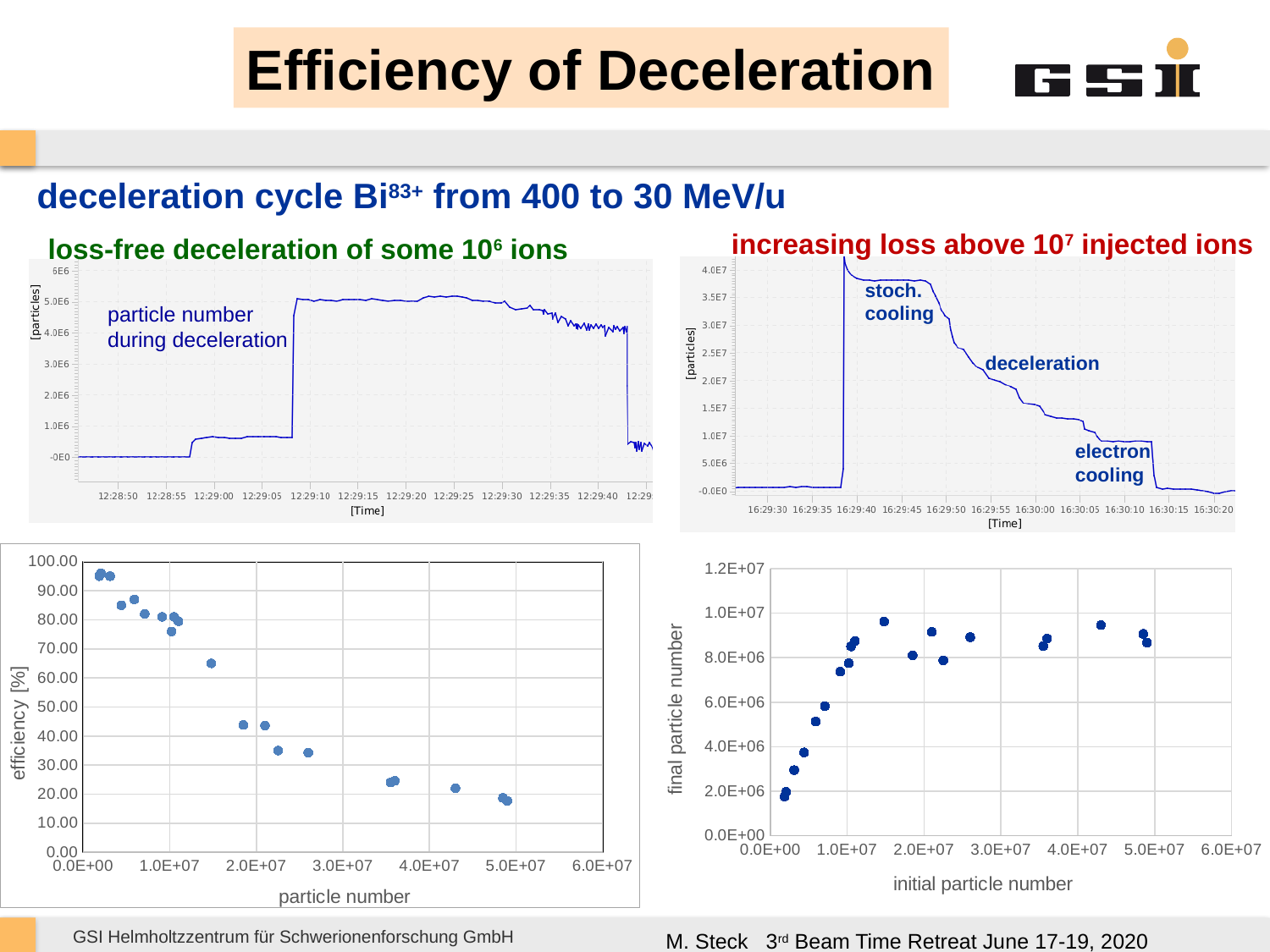
In the bottom-right chart, does the final particle number rise or fall as the initial particle number increases from 0 to 1.0E+07? rise What kind of chart is the bottom-left chart with the y axis labelled 'efficiency [%]'? scatter plot In the bottom-right chart, is the highest final particle number greater or less than 1.0E+07? less What is the x-axis label of the bottom-right chart? initial particle number In the bottom-left chart, is the efficiency for the points near 5.0E+07 particles greater or less than 20.00? less In the bottom-left chart, is the efficiency for the points closest to 0.0E+00 particles greater or less than 90.00? greater What kind of chart is the top-left chart labelled 'particle number during deceleration'? line chart In the bottom-left chart, does the efficiency rise or fall as the particle number increases along the x axis? fall Which three process stages are annotated on the top-right chart? stoch. cooling, deceleration, electron cooling